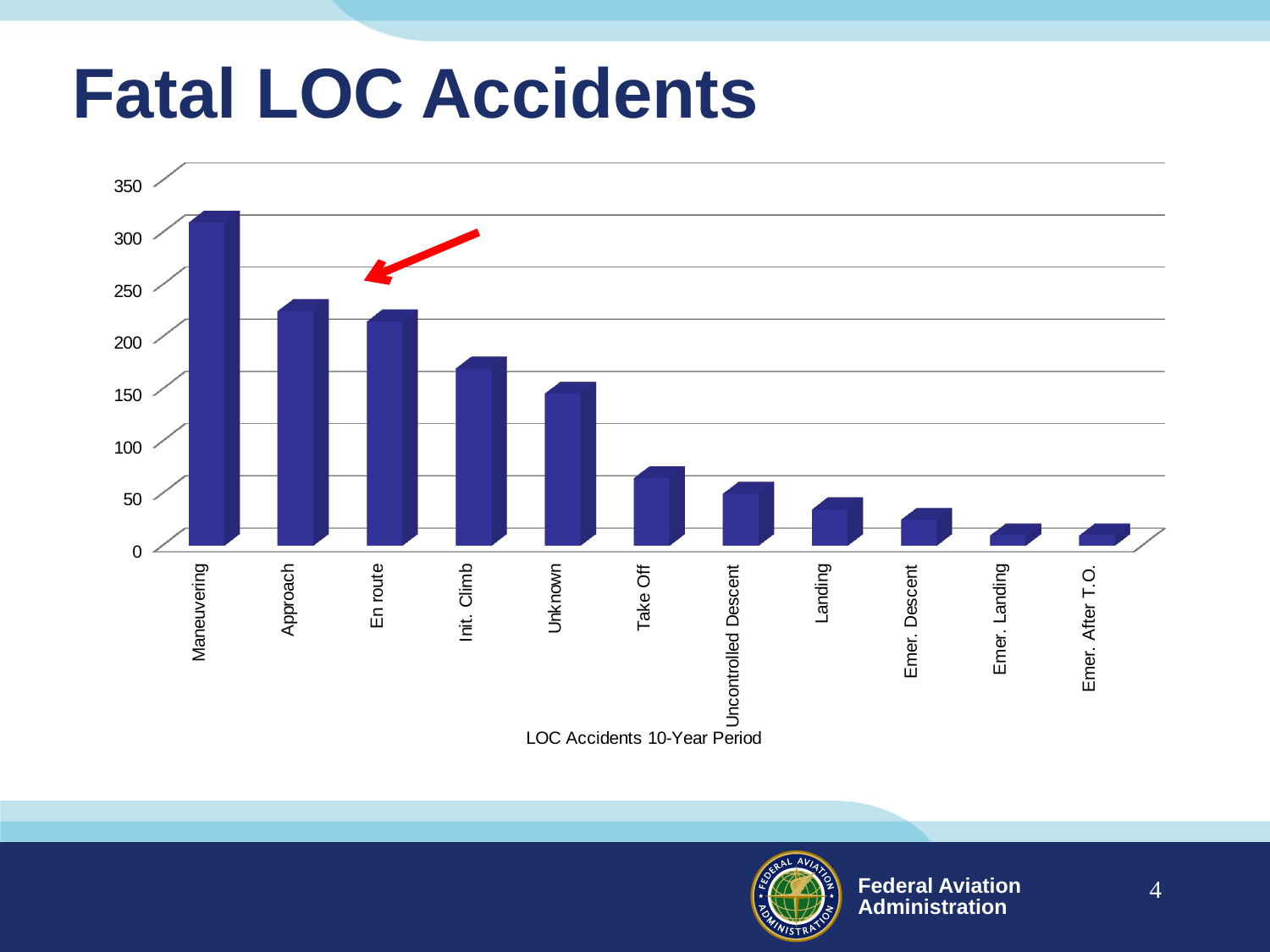
How many categories are shown on the x axis of the chart? 11 Do the values rise or fall moving from left to right along the x axis? Fall Is the value for Take Off greater or less than 100? less Which is larger, the value for Take Off or the value for Landing? Take Off Is the value for Approach greater or less than 250? less What kind of chart is shown on the slide? Bar chart Which category has the highest number of fatal LOC accidents? Maneuvering Which is larger, the value for Init. Climb or the value for Unknown? Init. Climb Is the value for Landing greater or less than 50? less What is the label shown beneath the x axis of the chart? LOC Accidents 10-Year Period